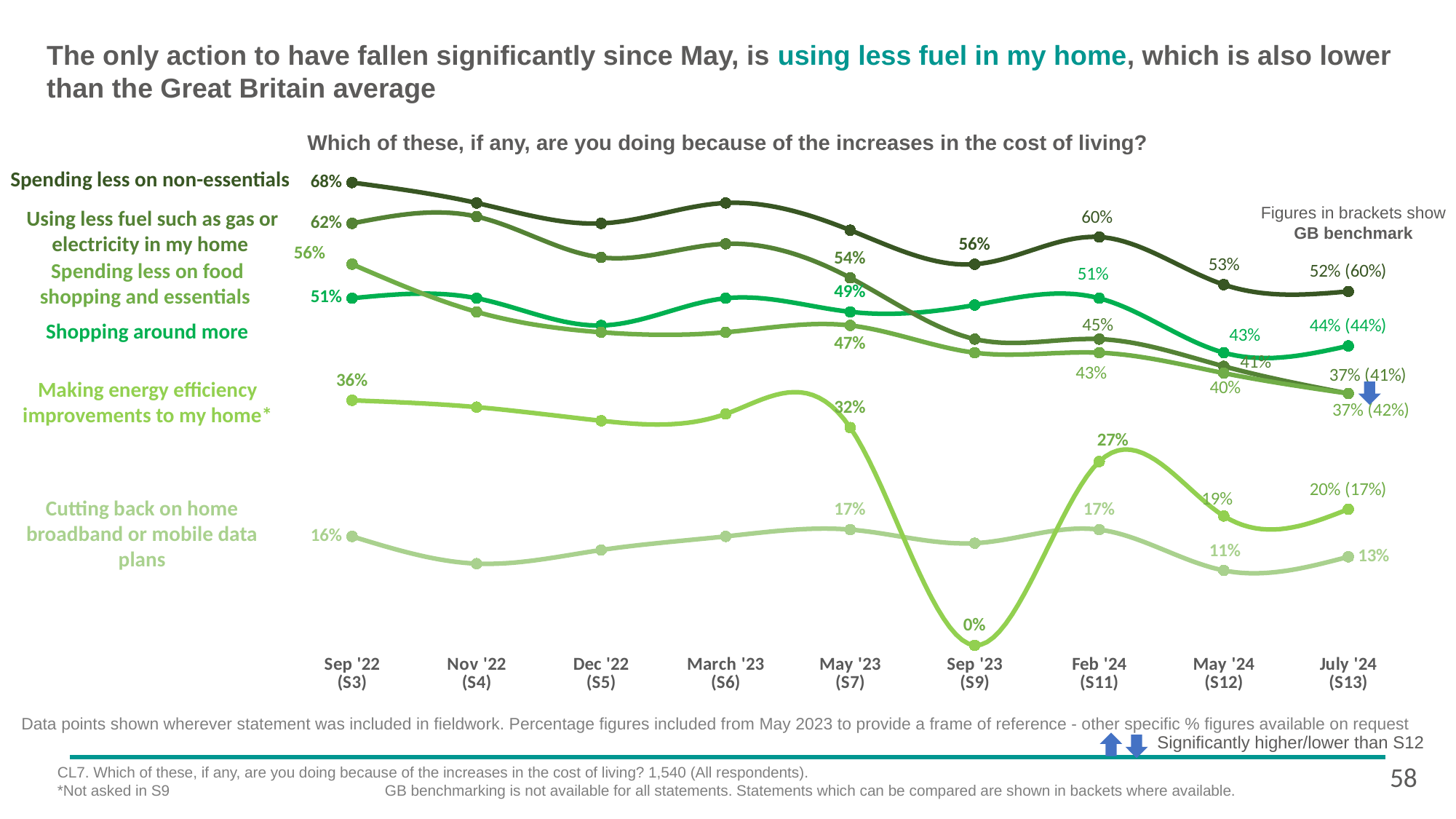
What was the value for 'Spending less on non-essentials' in July '24 (S13)? 52% In Feb '24, which was higher: 'Spending less on non-essentials' or 'Shopping around more'? Spending less on non-essentials What was the value for 'Making energy efficiency improvements to my home' in Feb '24 (S11)? 27% What is the GB benchmark shown in brackets for 'Spending less on non-essentials' in July '24? 60% How many survey waves (time points) are shown along the x axis? 9 How many statements (lines) are plotted on the chart? 6 Which statement had the highest value in Sep '22 (S3)? Spending less on non-essentials By how many percentage points did 'Spending less on non-essentials' fall between Sep '22 and July '24? 16 percentage points What was the value for 'Spending less on non-essentials' in Sep '22 (S3)? 68% What was the value for 'Cutting back on home broadband or mobile data plans' in May '24 (S12)? 11% What kind of chart is shown on the slide? Line chart Which statement had the lowest value in July '24 (S13)? Cutting back on home broadband or mobile data plans